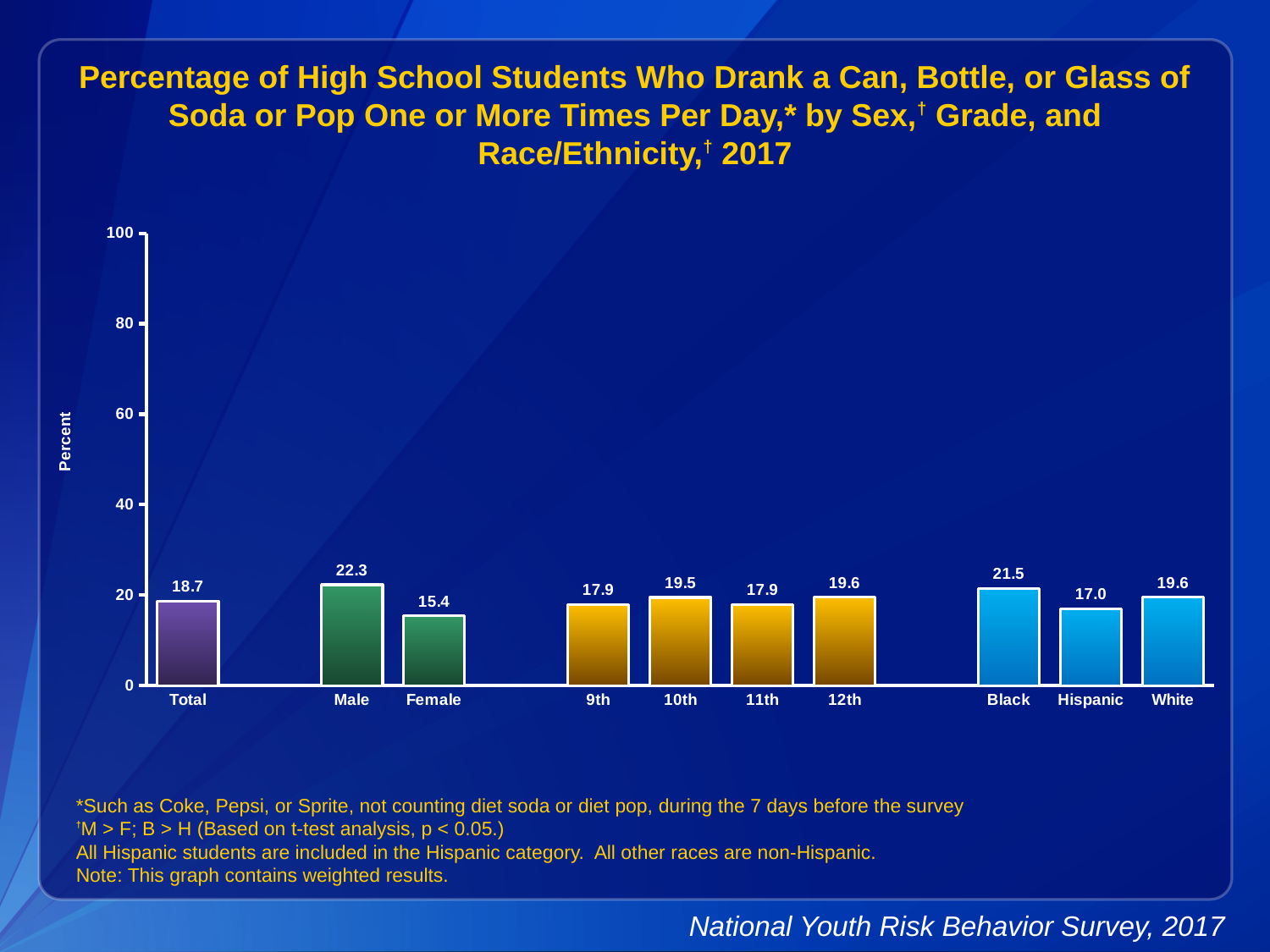
What is the value for Hispanic? 17.0 What is the difference between the Male and Female values? 6.9 Which category has the lowest value? Female What is the value for Total? 18.7 What kind of chart is shown? bar chart How many categories are shown on the x axis? 10 What is the difference between the 12th grade and 9th grade values? 1.7 Is the value for Female greater or less than 20? less Which category has the highest value? Male Which is larger, the value for Black or the value for White? Black What is the label of the y axis? Percent What is the value for Male? 22.3